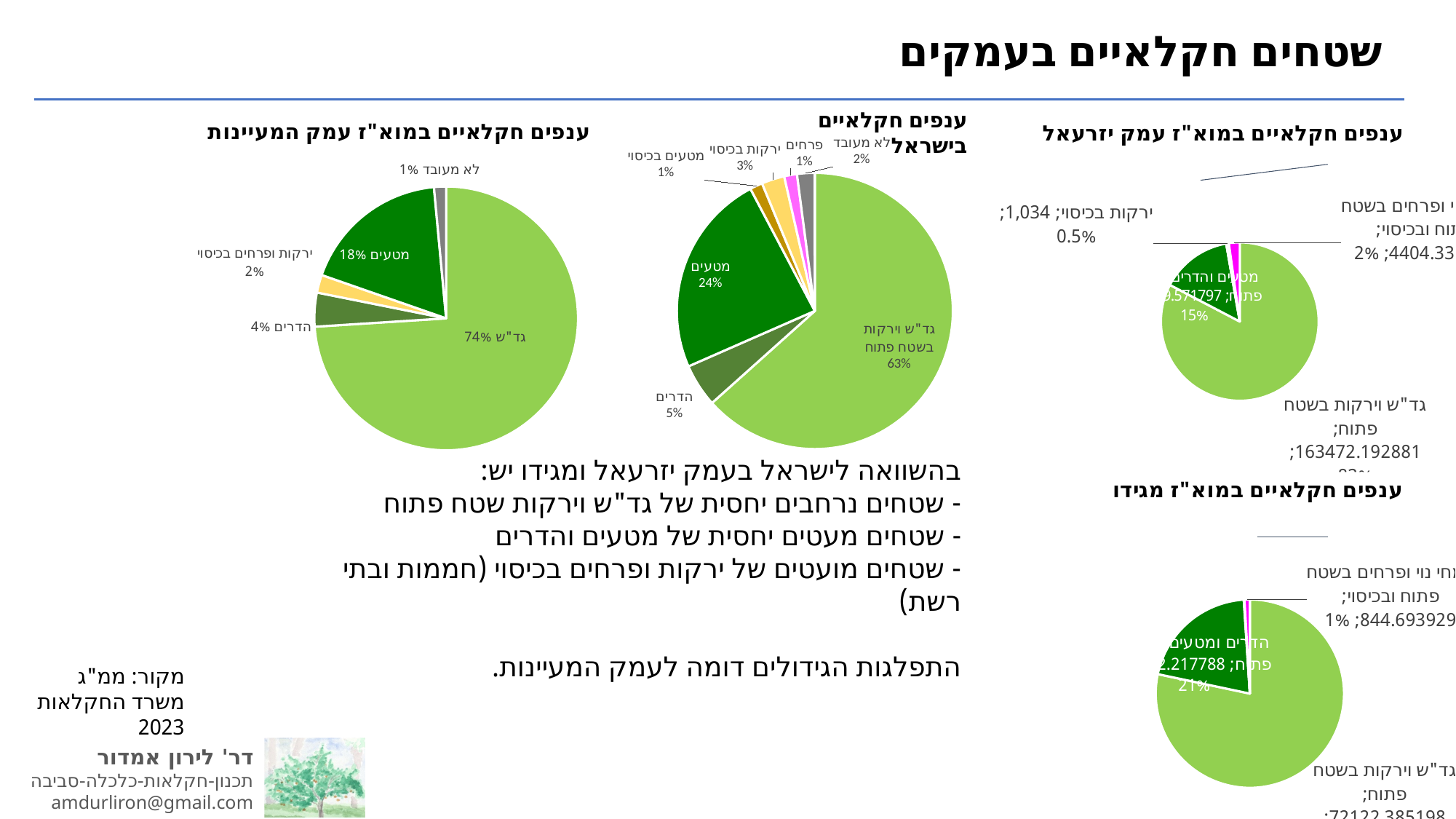
In the chart titled "ענפים חקלאיים במוא"ז עמק יזרעאל", what value is shown for ירקות בכיסוי? 1,034 In the chart titled "ענפים חקלאיים במוא"ז עמק המעיינות", what percentage is shown for מטעים? 18% In the chart titled "ענפים חקלאיים בישראל", how many slices does the pie have? 7 In the chart titled "ענפים חקלאיים במוא"ז עמק המעיינות", which category has the smallest slice? לא מעובד In the chart titled "ענפים חקלאיים בישראל", what is the difference in percentage points between מטעים and הדרים? 19 In the chart titled "ענפים חקלאיים בישראל", what percentage is shown for גד"ש וירקות בשטח פתוח? 63% In the chart titled "ענפים חקלאיים במוא"ז עמק המעיינות", how many slices does the pie have? 5 What type of chart is used for "ענפים חקלאיים במוא"ז מגידו"? Pie chart In the chart titled "ענפים חקלאיים בישראל", what percentage is shown for מטעים? 24% In the chart titled "ענפים חקלאיים במוא"ז מגידו", what percentage is shown for הדרים ומטעים? 21% In the chart titled "ענפים חקלאיים בישראל", which is larger, ירקות בכיסוי or לא מעובד? ירקות בכיסוי In the chart titled "ענפים חקלאיים במוא"ז עמק המעיינות", what share of the pie is גד"ש? 74%